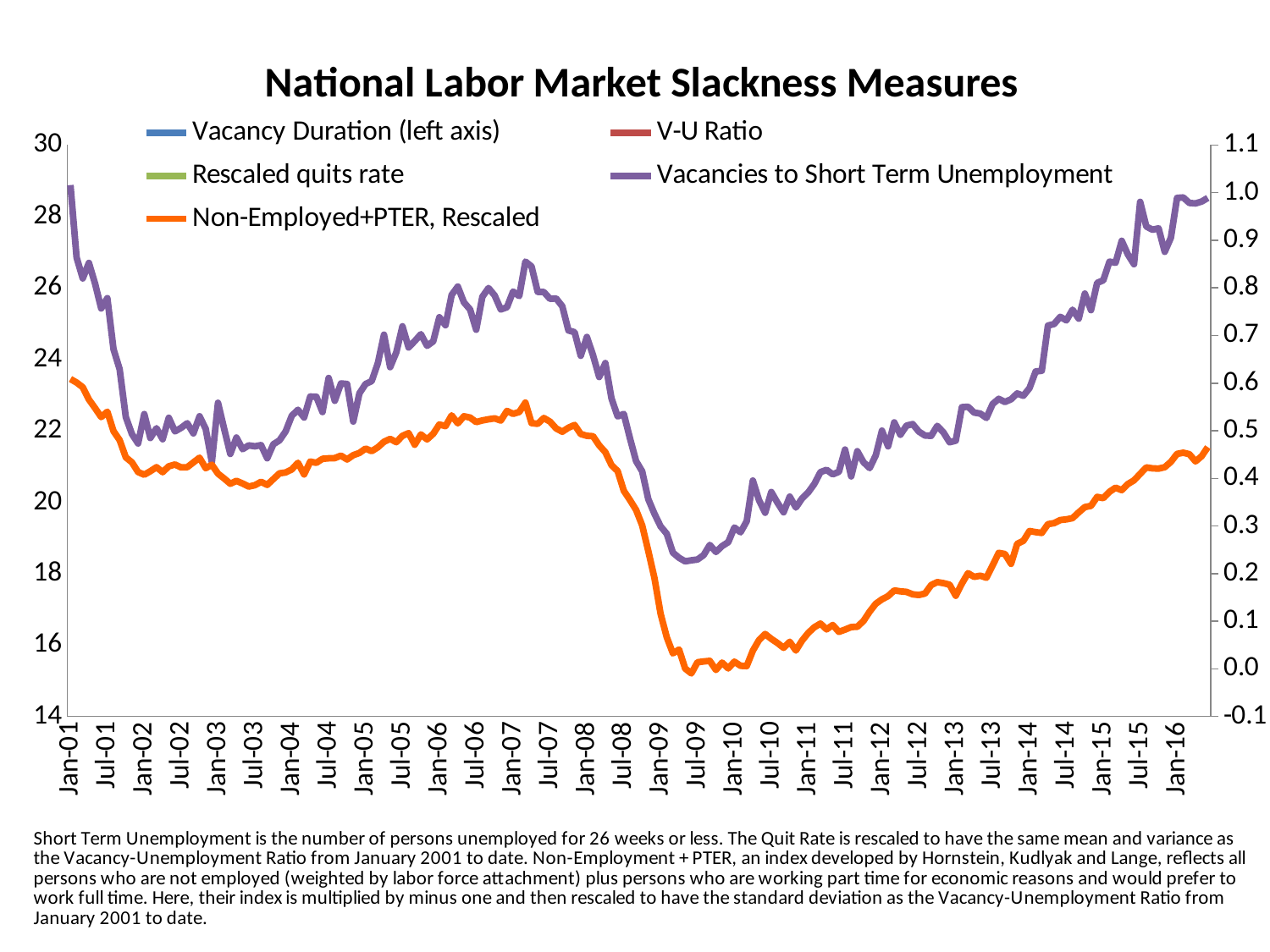
Is the value of the Vacancies to Short Term Unemployment line at Jul-09 greater or less than 0.3 on the right axis? less Is the Vacancies to Short Term Unemployment line higher at Jan-01 or at Jul-09? Jan-01 Which series is drawn in purple? Vacancies to Short Term Unemployment What kind of chart is shown on the slide? line chart What is the title of the chart? National Labor Market Slackness Measures Is the value of the Vacancies to Short Term Unemployment line at Jan-16 greater or less than 0.9 on the right axis? greater How many series does the chart's legend list? 5 Does the Vacancies to Short Term Unemployment line rise or fall between Jan-10 and Jan-16? rise Does the Non-Employed+PTER, Rescaled line rise or fall between Jan-08 and Jul-09? fall Around which labelled date does the Non-Employed+PTER, Rescaled line reach its lowest point? Jul-09